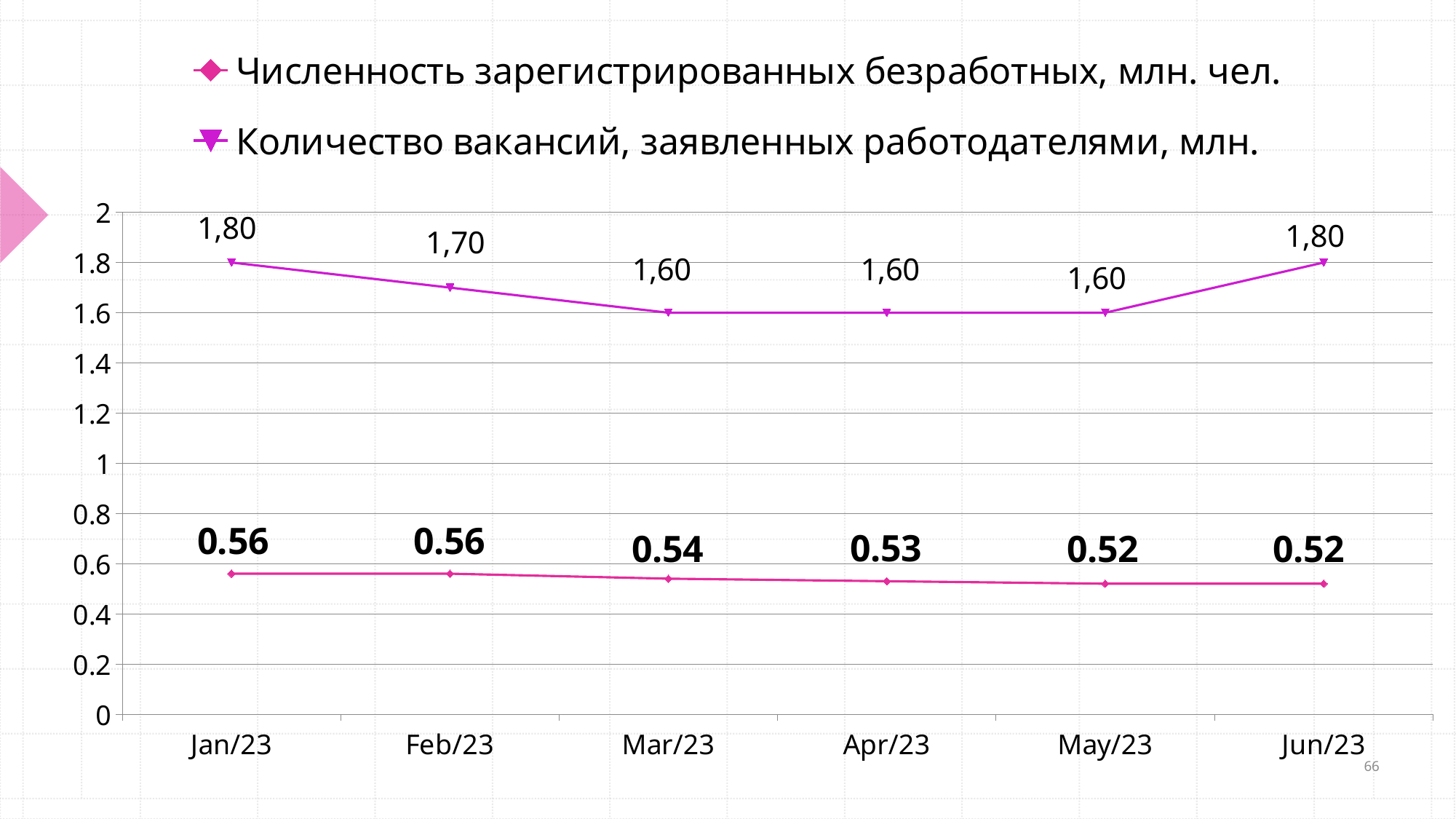
How many months are plotted along the x axis? 6 What is the difference between the 'Численность зарегистрированных безработных, млн. чел.' values for Jan/23 and Jun/23? 0.04 Does 'Численность зарегистрированных безработных, млн. чел.' rise or fall from Jan/23 to Jun/23? fall What is the value of 'Количество вакансий, заявленных работодателями, млн.' for Feb/23? 1,70 Which series has the higher value in Apr/23: 'Численность зарегистрированных безработных, млн. чел.' or 'Количество вакансий, заявленных работодателями, млн.'? Количество вакансий, заявленных работодателями, млн. In which month is 'Численность зарегистрированных безработных, млн. чел.' at its lowest value? May/23 and Jun/23 What type of chart is shown on the slide? line chart How many series does the legend list? 2 What is the difference between the 'Количество вакансий, заявленных работодателями, млн.' values for Jan/23 and Mar/23? 0,20 What is the value of 'Количество вакансий, заявленных работодателями, млн.' for Jun/23? 1,80 In which months does 'Количество вакансий, заявленных работодателями, млн.' reach its highest value? Jan/23 and Jun/23 What is the value of 'Численность зарегистрированных безработных, млн. чел.' for Mar/23? 0.54